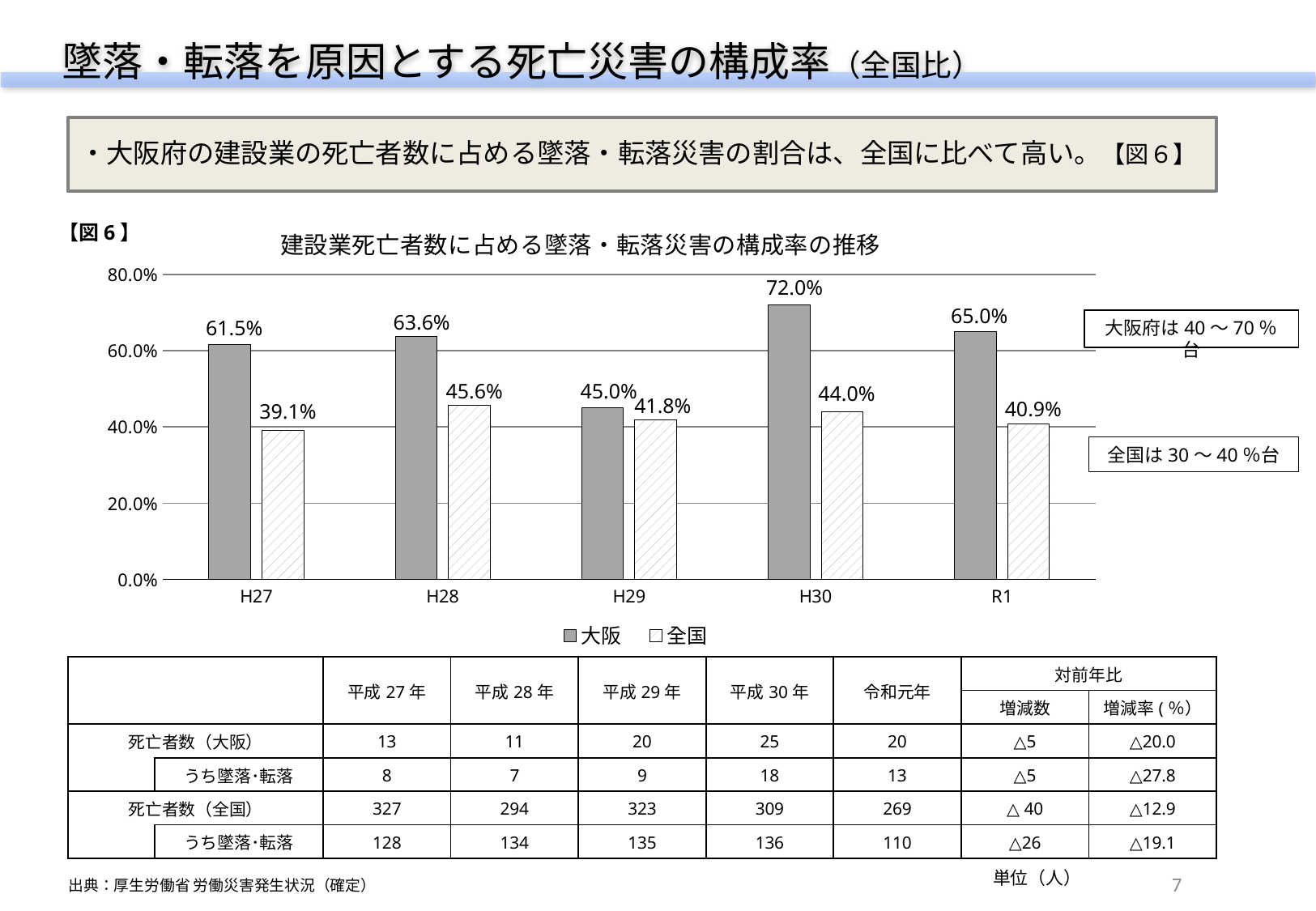
What is the value for 大阪 in H29? 45.0% In which year is the 大阪 value highest? H30 In which year is the 全国 value lowest? H27 What is the value for 大阪 in H30? 72.0% What is the value for 全国 in R1? 40.9% How many years are shown on the x axis? 5 Is the value for 大阪 in R1 greater or less than 60.0%? greater What is the difference between the 大阪 and 全国 values in H30? 28.0% What kind of chart is shown? bar chart Which is larger in H28, the 大阪 value or the 全国 value? 大阪 What is the value for 全国 in H27? 39.1% How many series does the legend list? 2